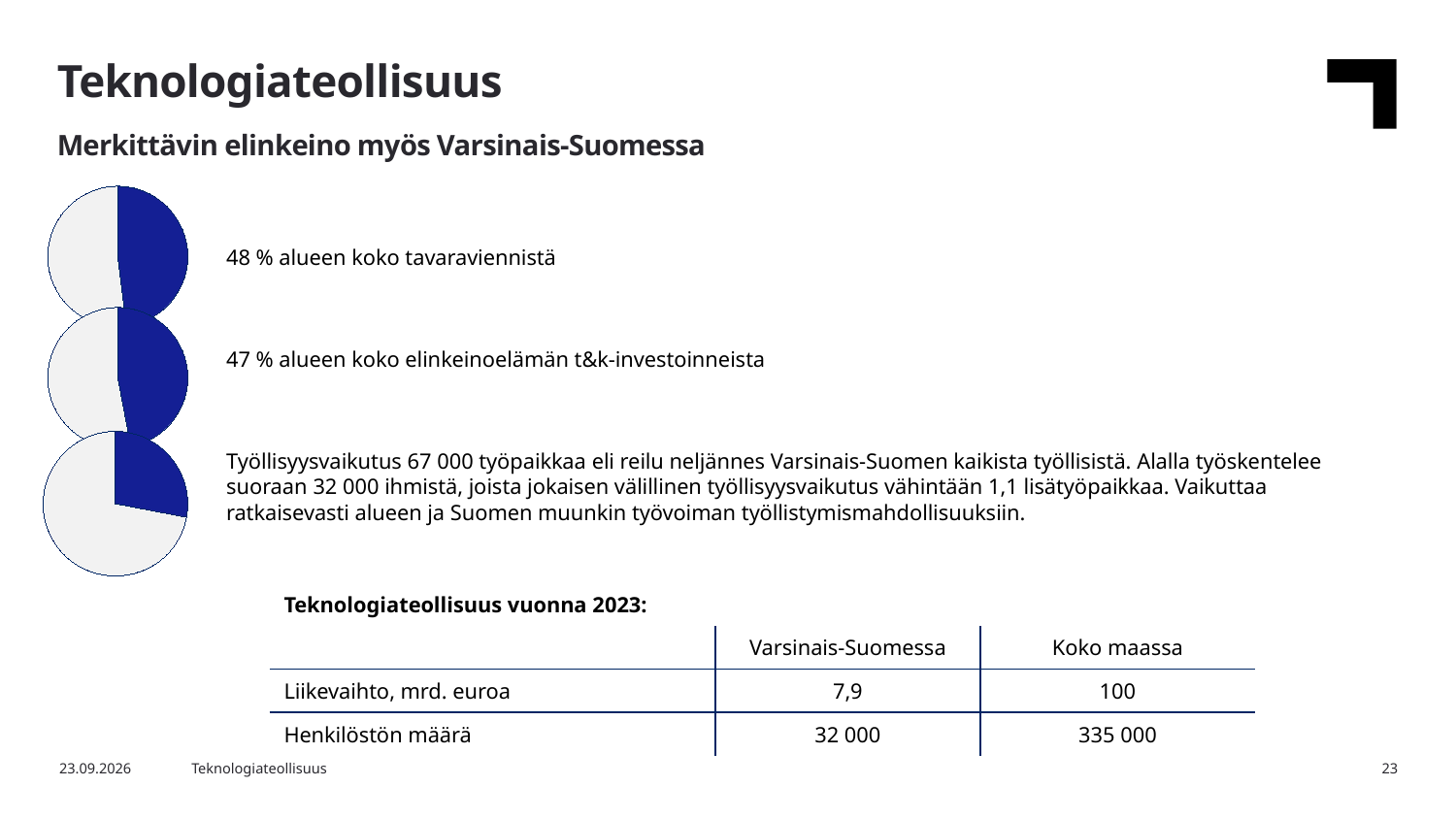
In the top pie chart, is the blue slice greater or less than 25% of the pie? greater According to the text next to the top pie chart, what share of the region's total goods exports does the technology industry account for? 48 % How many pie charts are on the slide? 3 Is the blue slice in the middle pie chart larger or smaller than the blue slice in the bottom pie chart? Larger What kind of charts are shown on the left side of the slide? Pie charts How many slices does each pie chart have? 2 In the bottom pie chart, is the blue slice greater or less than 50% of the pie? less What colour is used for the highlighted slice in each pie chart? Blue According to the text next to the middle pie chart, what share of the region's business R&D investments does the technology industry account for? 47 % Which of the three pie charts has the smallest highlighted (blue) slice? The bottom pie chart What is the difference between the share shown for the top pie chart (goods exports) and the middle pie chart (R&D investments)? 1 percentage point